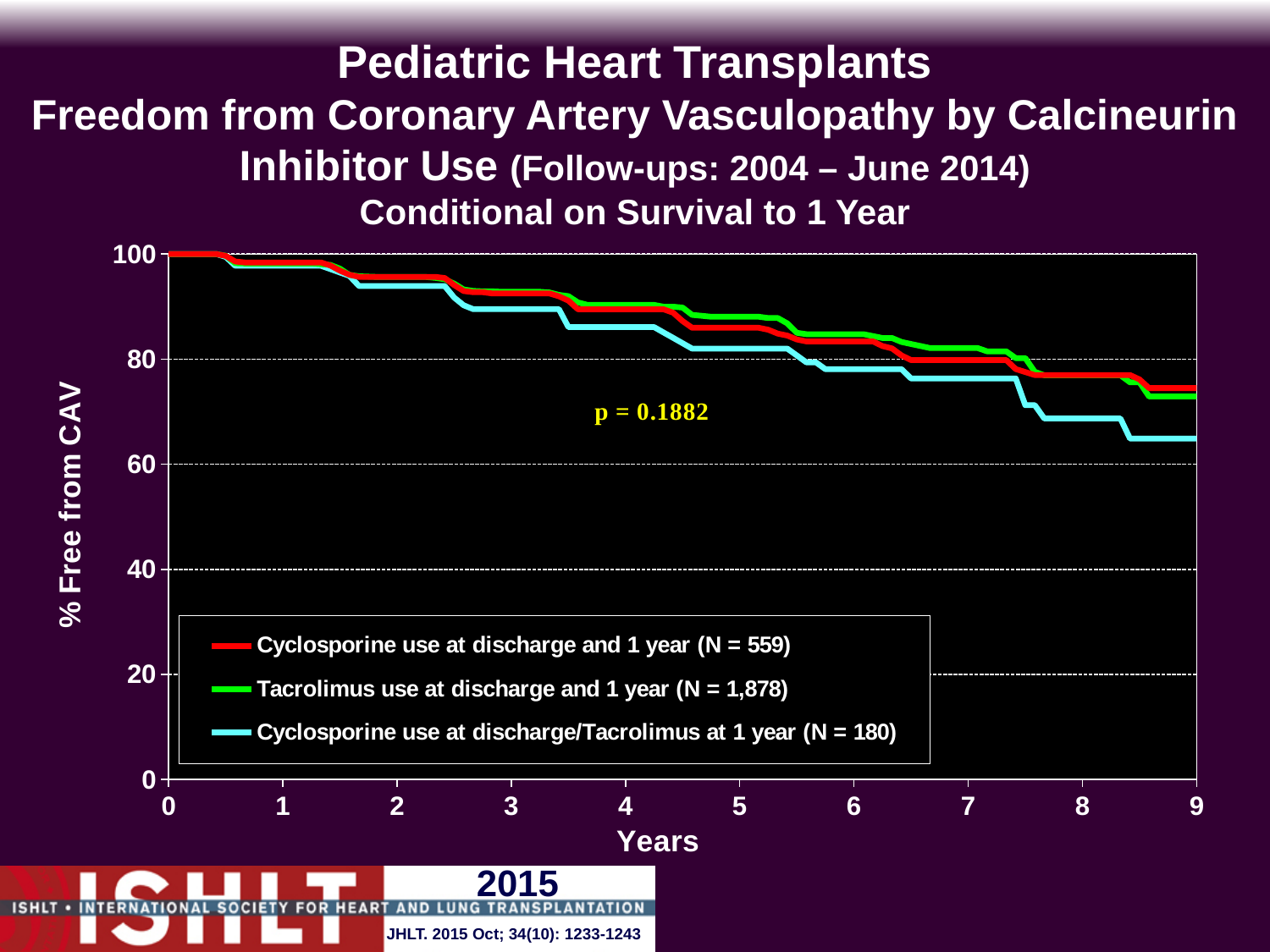
How many series does the legend list? 3 What is the label of the y axis? % Free from CAV At year 9, is the value for the Cyclosporine use at discharge and 1 year series greater or less than 80? less Do the values for the Tacrolimus use at discharge and 1 year series rise or fall as the years increase? fall At year 3, is the value for the Tacrolimus use at discharge and 1 year series greater or less than 80? greater At year 8, which series has the lower value: Cyclosporine use at discharge and 1 year or Cyclosporine use at discharge/Tacrolimus at 1 year? Cyclosporine use at discharge/Tacrolimus at 1 year Which series has the lowest value at year 9? Cyclosporine use at discharge/Tacrolimus at 1 year At year 9, is the value for the Cyclosporine use at discharge/Tacrolimus at 1 year series greater or less than 60? greater What is the N for the Tacrolimus use at discharge and 1 year series in the legend? 1,878 What kind of chart is shown on the slide? line chart What p-value is printed on the chart? p = 0.1882